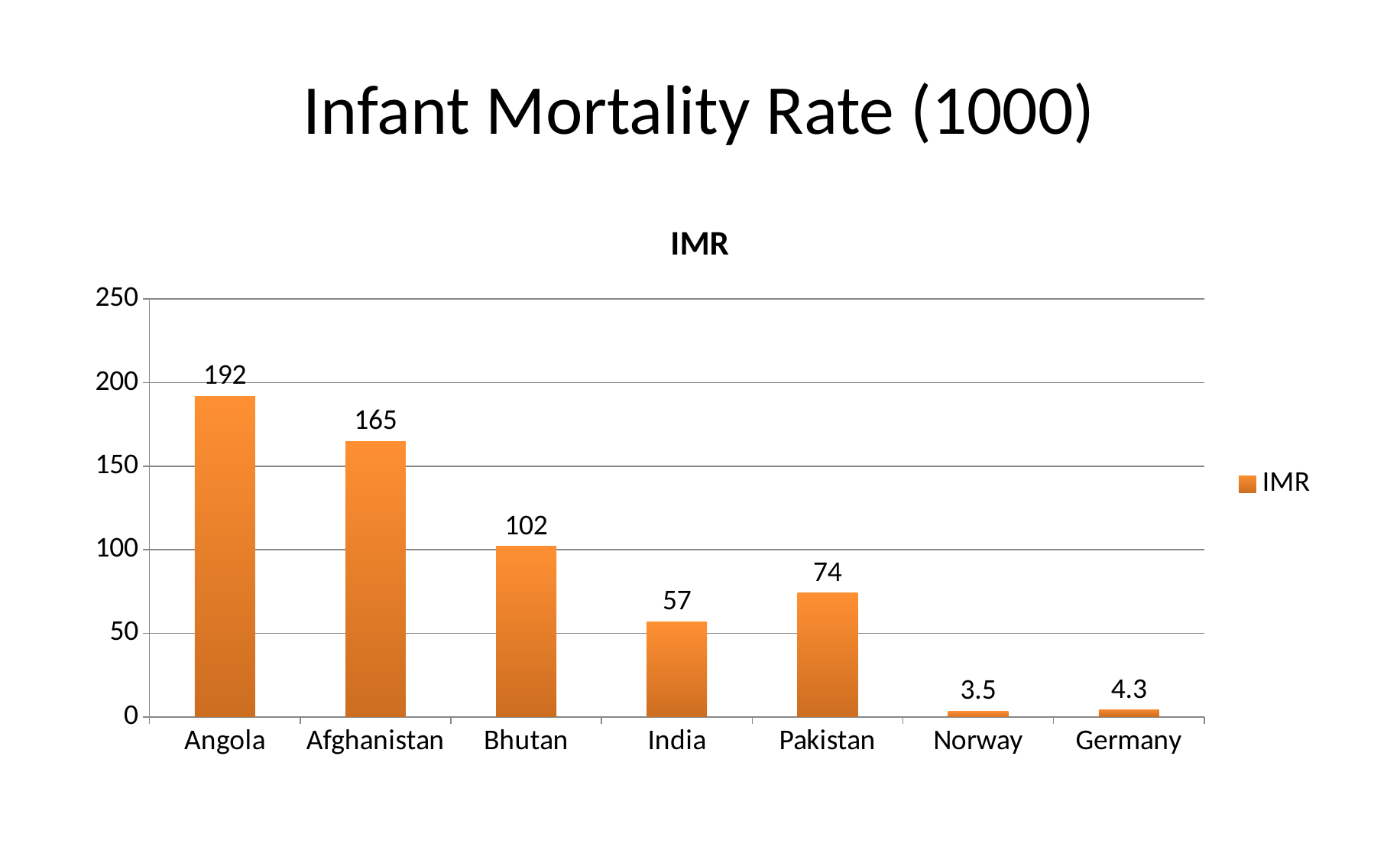
What is the title of the chart? IMR Which country has the highest IMR? Angola What is the IMR value for India? 57 Which country has the lowest IMR? Norway How many countries are shown on the chart? 7 What is the difference between the IMR values for Angola and Afghanistan? 27 Is the IMR value for Afghanistan greater or less than 150? greater What is the IMR value for Norway? 3.5 What kind of chart is shown on the slide? Bar chart Which has a higher IMR, Bhutan or Pakistan? Bhutan What is the IMR value for Angola? 192 What is the difference between the IMR values for Pakistan and India? 17